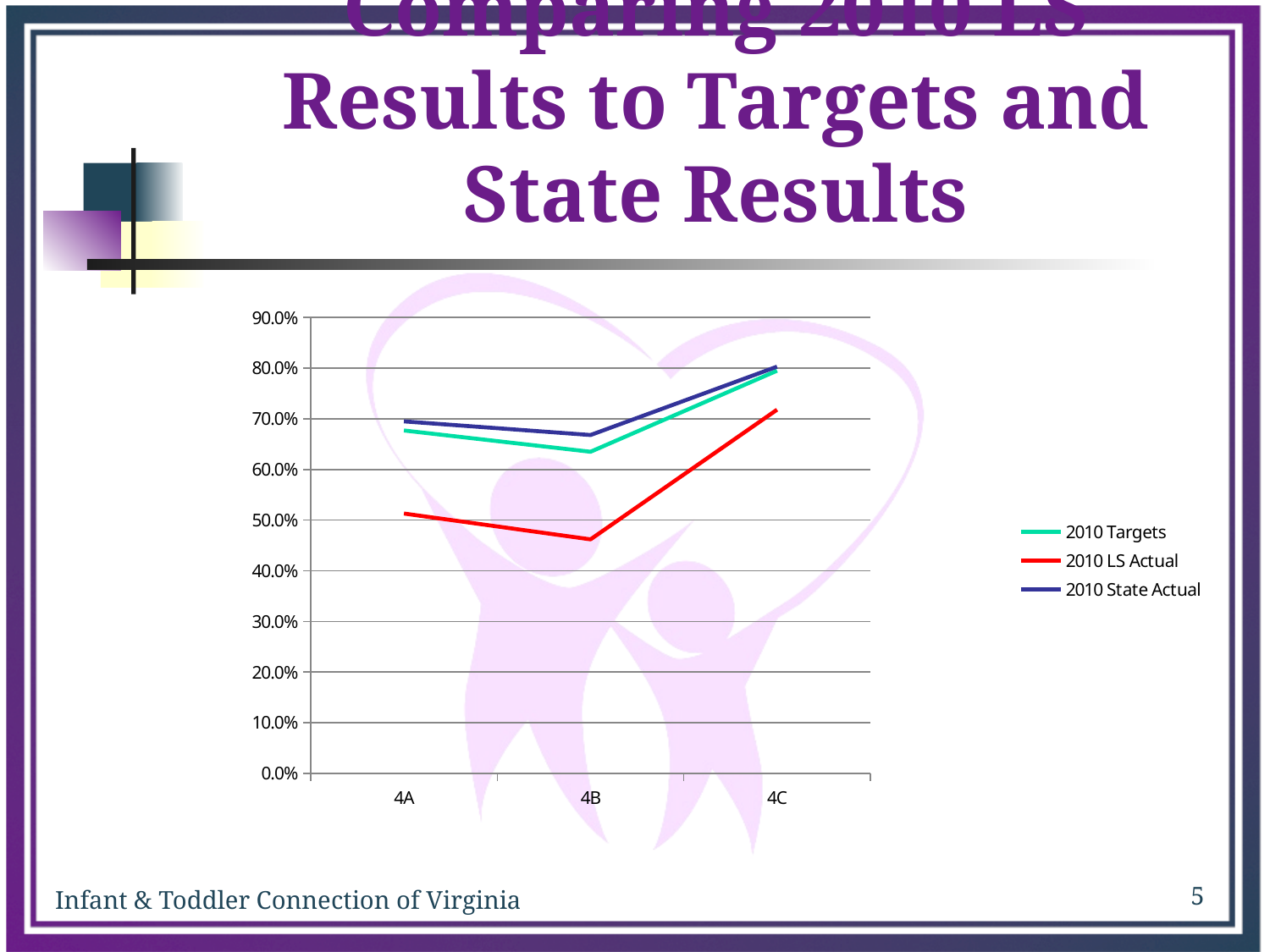
Does the 2010 LS Actual line rise or fall from 4B to 4C? rise Is the value for 2010 LS Actual at 4A greater or less than 60%? less What kind of chart is shown on the slide? line chart How many categories are shown on the x axis? 3 At 4B, which is larger: 2010 Targets or 2010 LS Actual? 2010 Targets How many series does the legend list? 3 For the 2010 LS Actual series, which category has the highest value? 4C Is the value for 2010 LS Actual at 4C greater or less than 80%? less Is the value for 2010 LS Actual at 4B greater or less than 50%? less For the 2010 Targets series, which category has the lowest value? 4B